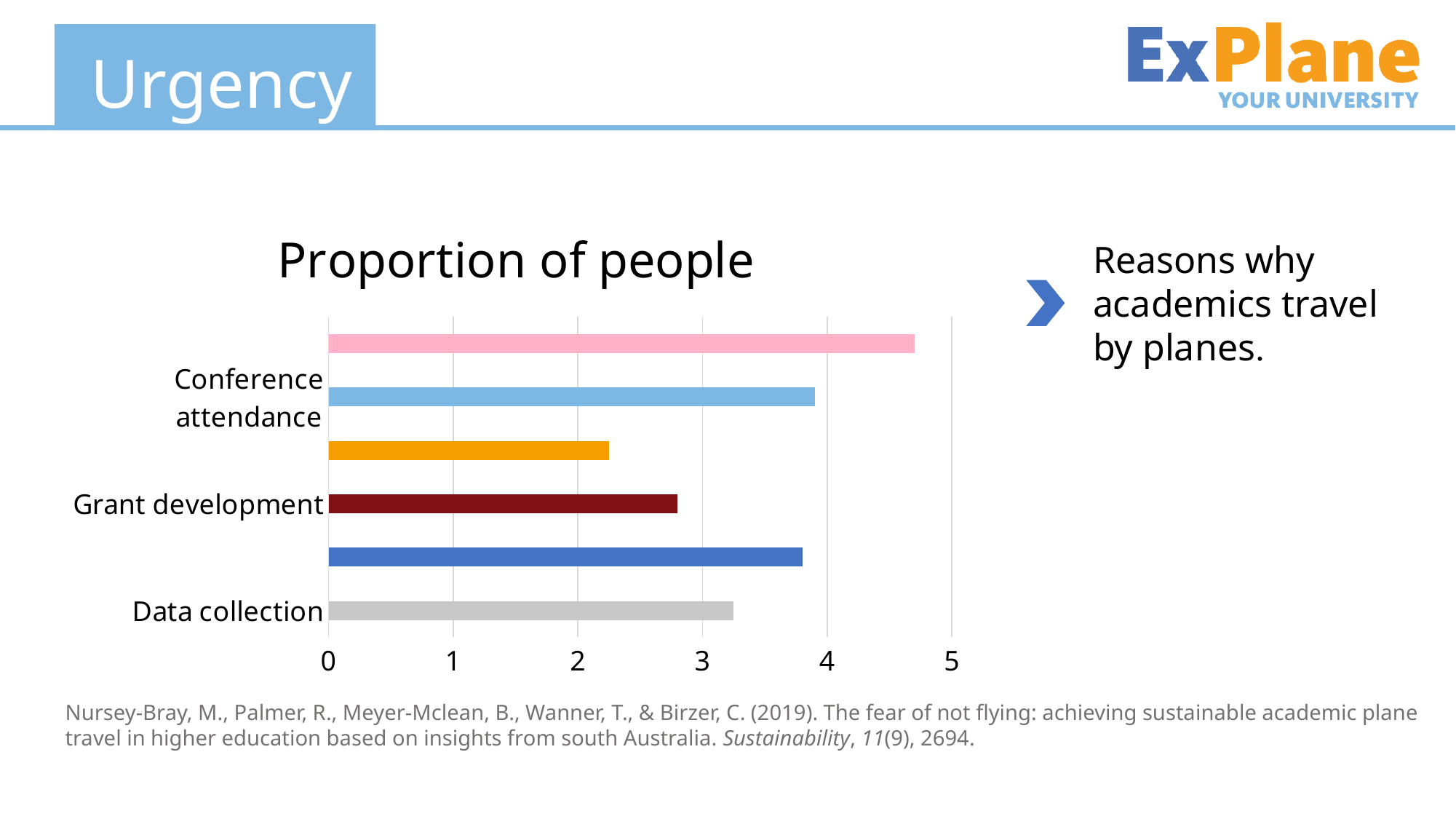
Is the value for Conference attendance greater or less than 3? greater What kind of chart is shown on the slide? Bar chart Is the value for Conference attendance greater or less than 4? less Which is larger, the value for Data collection or the value for Grant development? Data collection What colour is the longest bar in the chart? Pink Is the value for Data collection greater or less than 4? less Which is larger, the value for Conference attendance or the value for Grant development? Conference attendance How many bars are plotted in the chart? 6 What is the title of the chart? Proportion of people